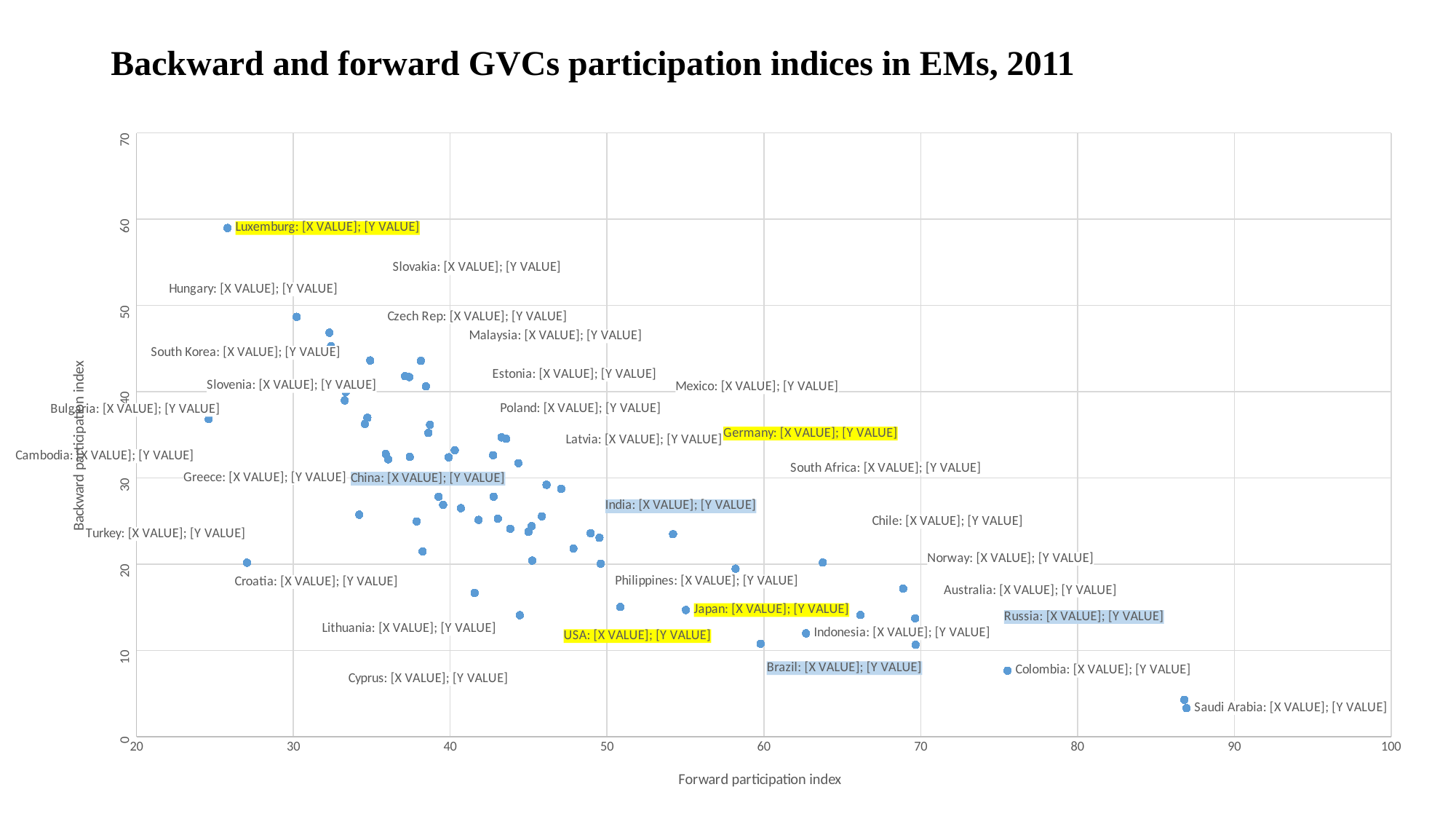
Is the backward participation index for Colombia greater or less than 10? less Is the backward participation index for Saudi Arabia greater or less than 10? less What is the title of the chart? Backward and forward GVCs participation indices in EMs, 2011 What kind of chart is shown on the slide? Scatter chart Is the forward participation index for Luxemburg greater or less than 30? less Which country has a higher forward participation index, Saudi Arabia or Luxemburg? Saudi Arabia What is the label of the horizontal axis? Forward participation index Which country has a higher backward participation index, Luxemburg or Saudi Arabia? Luxemburg What is the highest value shown on the vertical axis? 70